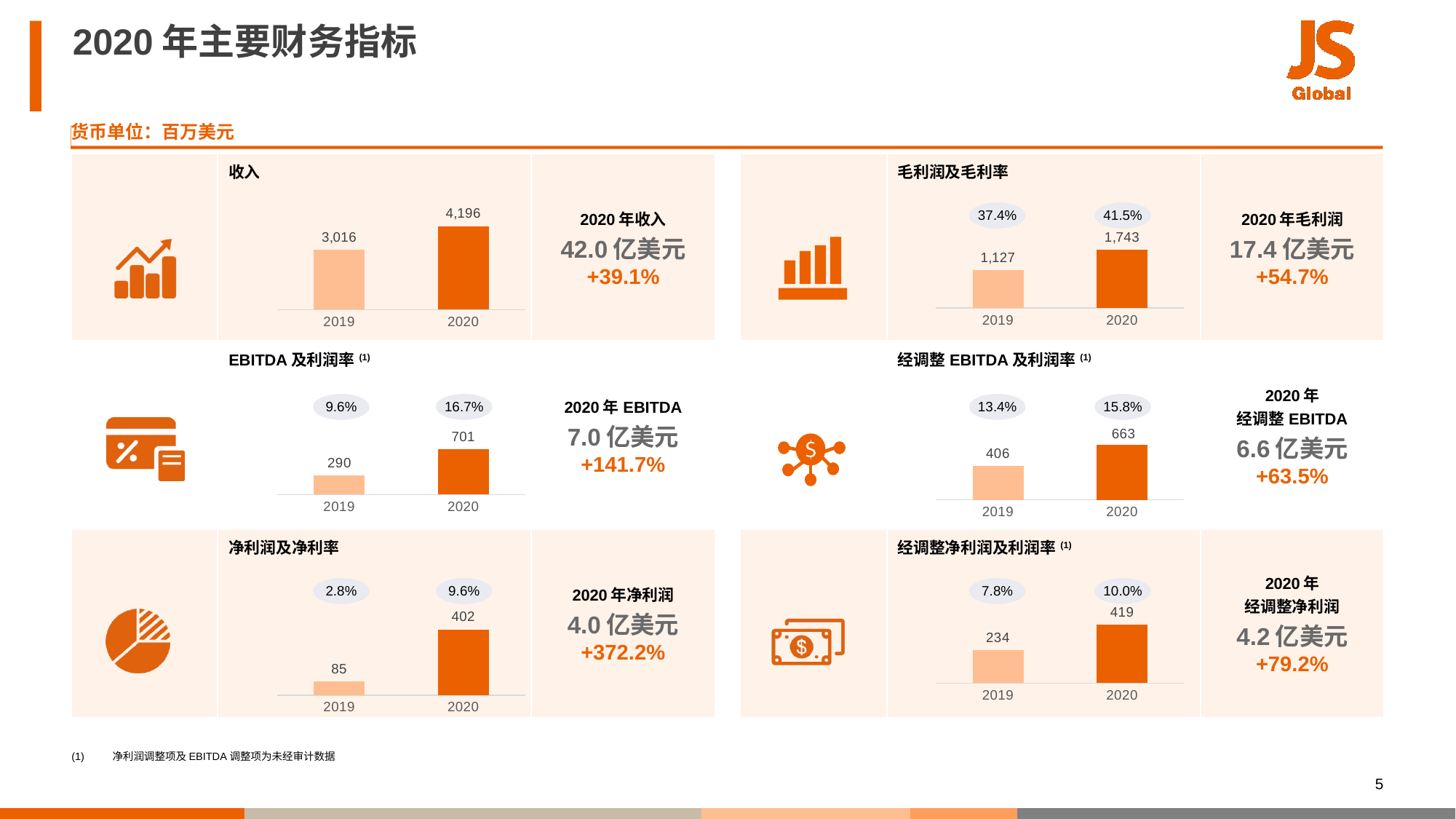
What type of chart is the 收入 chart? Bar chart In the EBITDA 及利润率 chart, what is the difference between the 2020 and 2019 values? 411 In the 经调整 EBITDA 及利润率 chart, what margin percentage is shown above the 2019 bar? 13.4% In the 毛利润及毛利率 chart, what margin percentage is shown above the 2020 bar? 41.5% How many bars does the 净利润及净利率 chart show? 2 In the 收入 chart, what is the value for 2020? 4,196 In the 净利润及净利率 chart, which year has the lowest value? 2019 In the EBITDA 及利润率 chart, which year has the higher bar? 2020 In the 经调整净利润及利润率 chart, what is the value for 2020? 419 In the 毛利润及毛利率 chart, what is the value for 2019? 1,127 In the 收入 chart, what is the difference between the 2020 and 2019 values? 1,180 In the 经调整 EBITDA 及利润率 chart, what is the value for 2019? 406